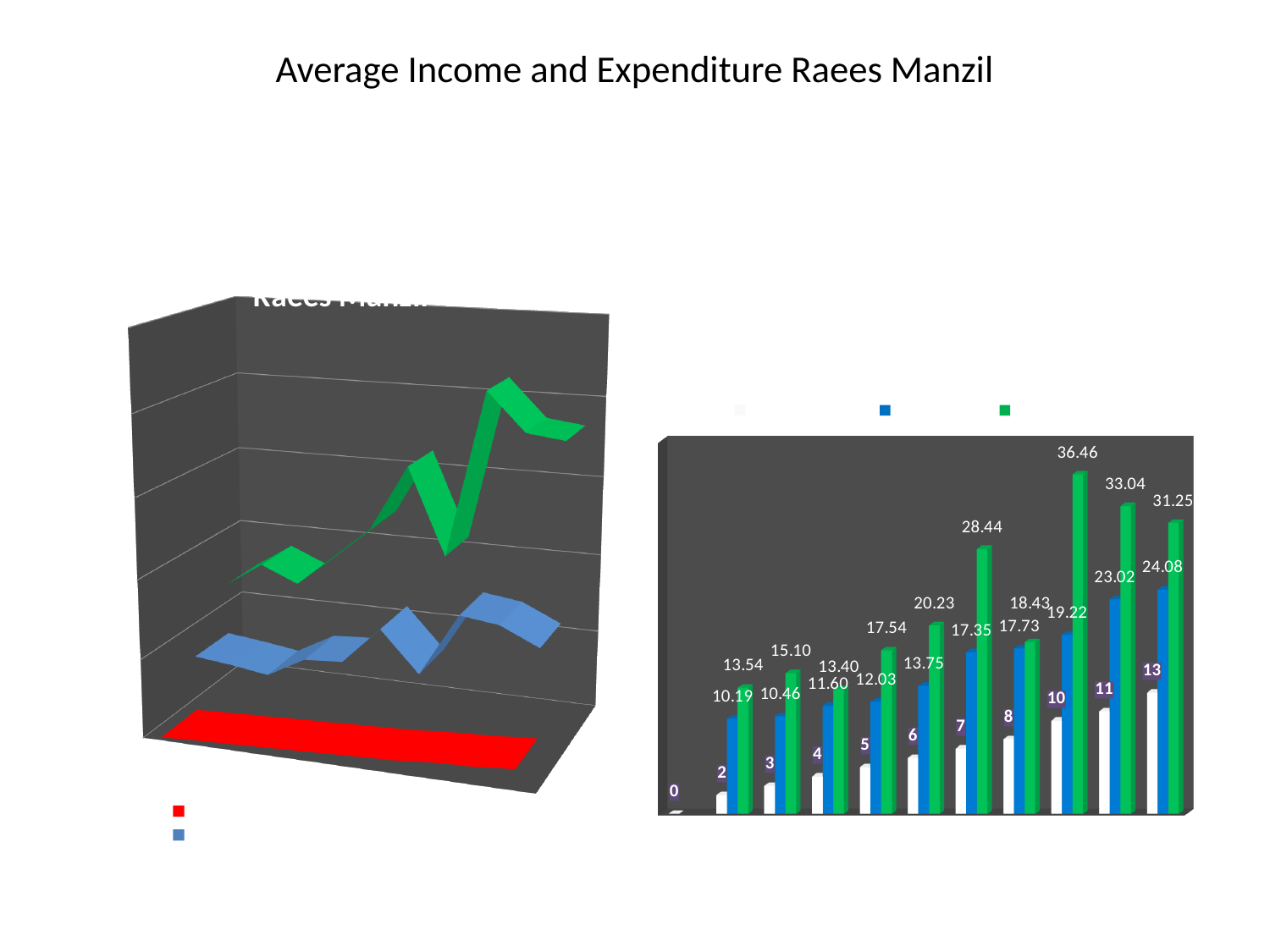
What kind of chart is the chart on the right of the slide? bar chart In the right-hand bar chart, do the blue bar values generally rise or fall from left to right? rise In the right-hand bar chart, what is the highest value labelled on a green bar? 36.46 In the right-hand bar chart, what is the lowest value labelled on a blue bar? 10.19 What kind of chart is the chart on the left of the slide? line chart In the right-hand bar chart, what is the difference between the two highest green bar values, 36.46 and 33.04? 3.42 In the right-hand bar chart, in the rightmost group, which is larger: the green bar or the blue bar? green bar In the right-hand bar chart, what is the value of the blue bar in the rightmost group? 24.08 How many series does the legend above the right-hand bar chart list? 3 In the right-hand bar chart, what is the lowest value labelled on a green bar? 13.40 In the right-hand bar chart, what is the highest value labelled on a blue bar? 24.08 In the right-hand bar chart, what is the value of the green bar in the rightmost group? 31.25